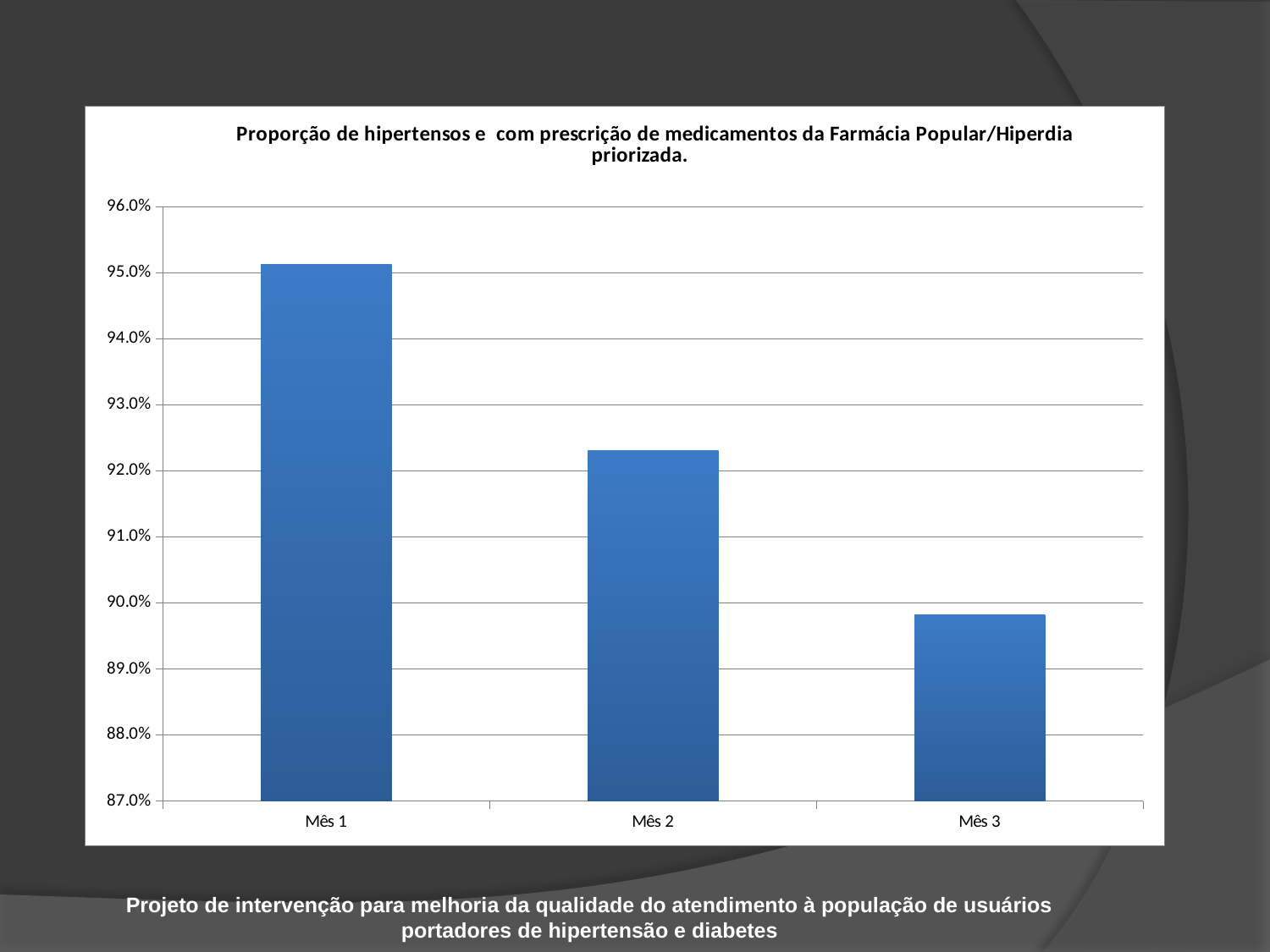
Which month has the highest proportion? Mês 1 What kind of chart is shown on the slide? bar chart What is the lowest value shown on the vertical axis? 87.0% Which is larger, the value for Mês 1 or the value for Mês 2? Mês 1 How many categories (months) are plotted on the chart? 3 Is the value for Mês 3 greater or less than 91.0%? less Which month has the lowest proportion? Mês 3 Which is larger, the value for Mês 2 or the value for Mês 3? Mês 2 What colour are the bars in the chart? blue Is the value for Mês 2 greater or less than 93.0%? less Do the values rise or fall from Mês 1 to Mês 3? fall Is the value for Mês 1 greater or less than 94.0%? greater